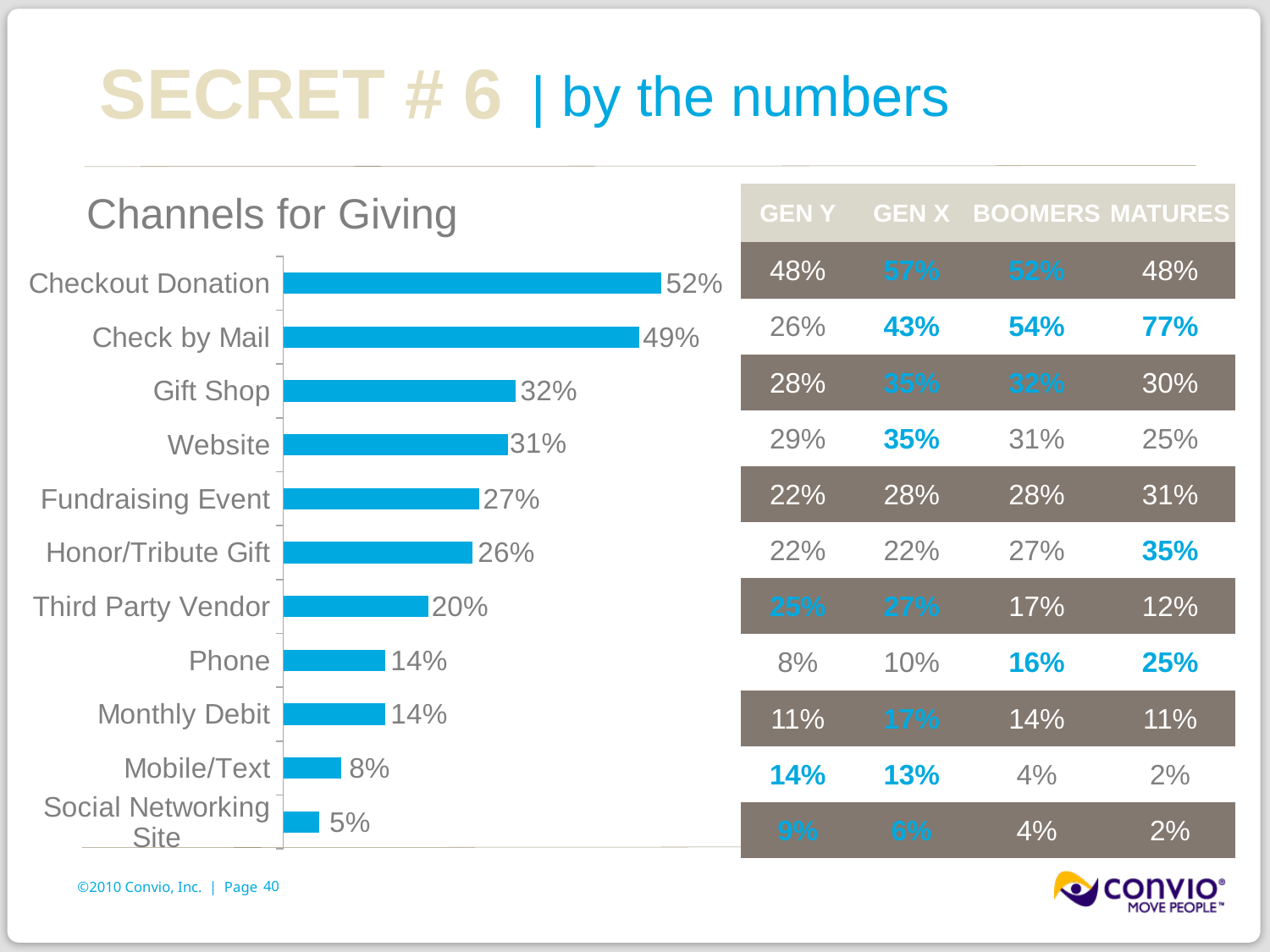
Which channel has the lowest value in the Channels for Giving chart? Social Networking Site In the Channels for Giving chart, what is the difference between Fundraising Event and Phone? 13 percentage points How many channels are shown in the Channels for Giving chart? 11 What kind of chart is the Channels for Giving chart? bar chart What is the value for Third Party Vendor in the Channels for Giving chart? 20% What is the title of the chart on the slide? Channels for Giving In the Channels for Giving chart, do the bar values decrease or increase going from the top category to the bottom category? decrease Which channel has the highest value in the Channels for Giving chart? Checkout Donation In the Channels for Giving chart, what is the difference between Checkout Donation and Check by Mail? 3 percentage points In the Channels for Giving chart, which is larger: Gift Shop or Website? Gift Shop What is the value for Mobile/Text in the Channels for Giving chart? 8% What is the value for Checkout Donation in the Channels for Giving chart? 52%